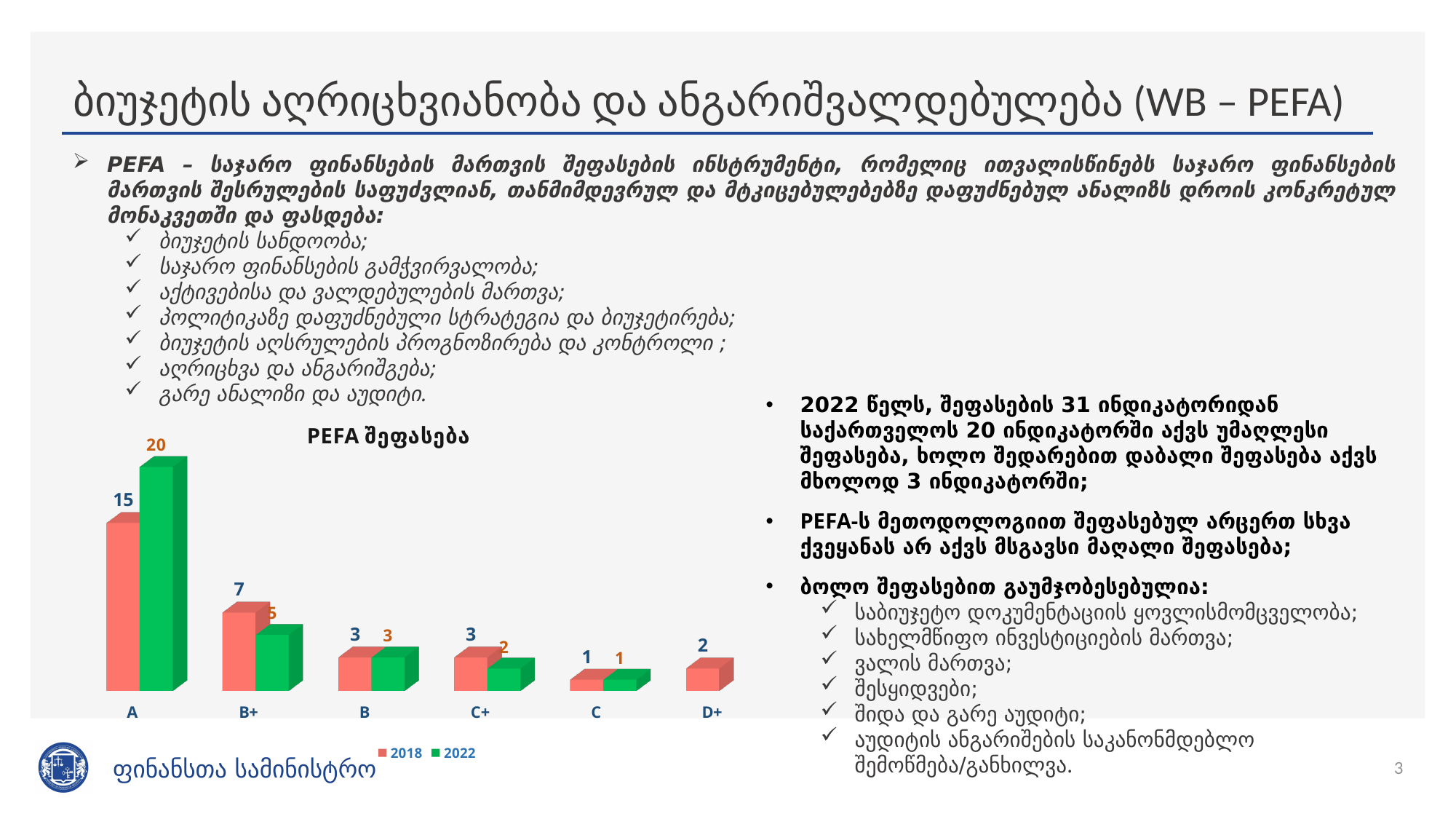
Which category has the lowest 2018 value? C Which category has the highest 2022 value? A What is the 2018 value for category B+? 7 What is the difference between the 2022 and 2018 values for category A? 5 What is the 2018 value for category D+? 2 How many categories are shown on the x axis? 6 Which is larger for category B+: the 2018 value or the 2022 value? 2018 How many series does the legend list? 2 What is the chart's title? PEFA შეფასება What is the 2022 value for category A? 20 Which series is shown in green in the legend? 2022 What type of chart is shown on the slide? bar chart